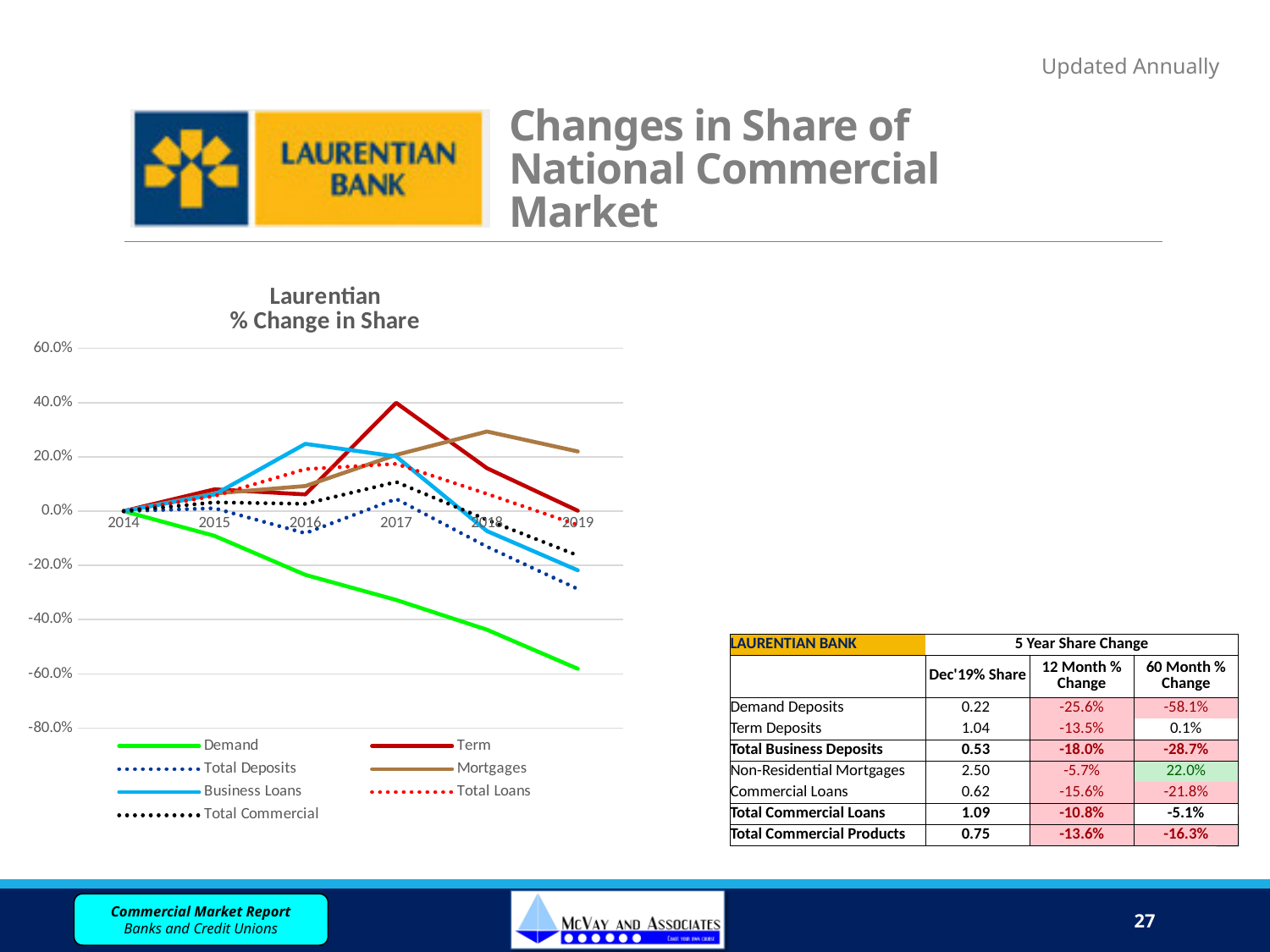
Is the value for Demand in 2019 greater or less than -40.0%? less In 2019, which is larger: Mortgages or Business Loans? Mortgages Which series has the lowest value in 2019? Demand How many years are plotted along the x axis of the chart? 6 What kind of chart is shown on the slide? line chart Is the value for Term in 2017 greater or less than 20.0%? greater Does the Demand series rise or fall from 2014 to 2019? fall Which series has the highest value in 2017? Term Is the value for Mortgages in 2018 greater or less than 20.0%? greater How many series does the chart legend list? 7 What is the title of the chart? Laurentian % Change in Share Which series has the highest value in 2019? Mortgages